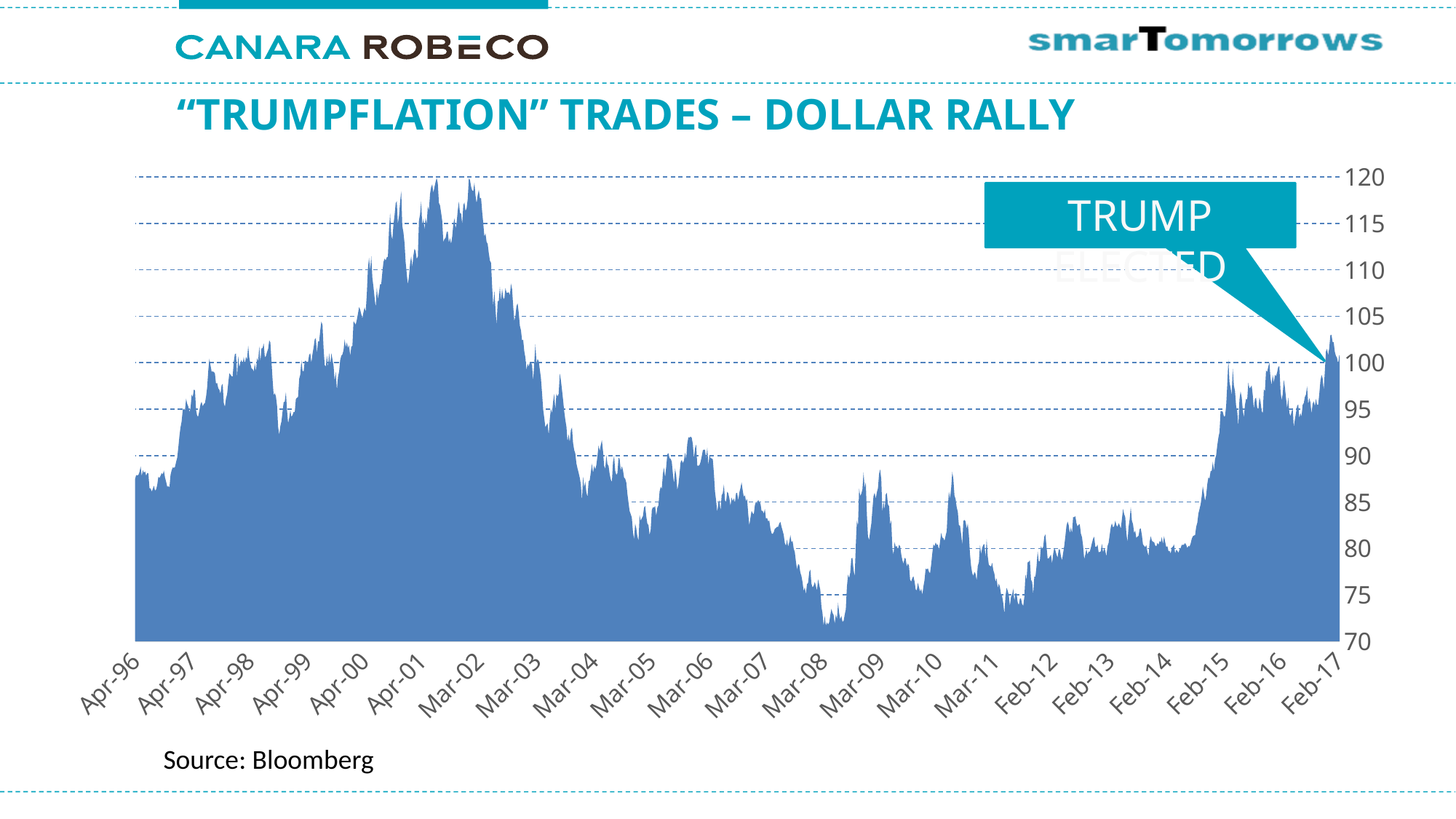
What is the title of the slide's chart? "TRUMPFLATION" TRADES – DOLLAR RALLY Is the value at Apr-96 greater or less than 90? less What source is cited for the chart data? Bloomberg Is the value at Apr-01 greater or less than 110? greater Is the value at Mar-08 greater or less than 80? less What kind of chart is shown on the slide? Area chart Around which x-axis label does the chart reach its highest value? Mar-02 Do the values rise or fall between Mar-02 and Mar-08? fall Around which x-axis label does the chart reach its lowest value? Mar-08